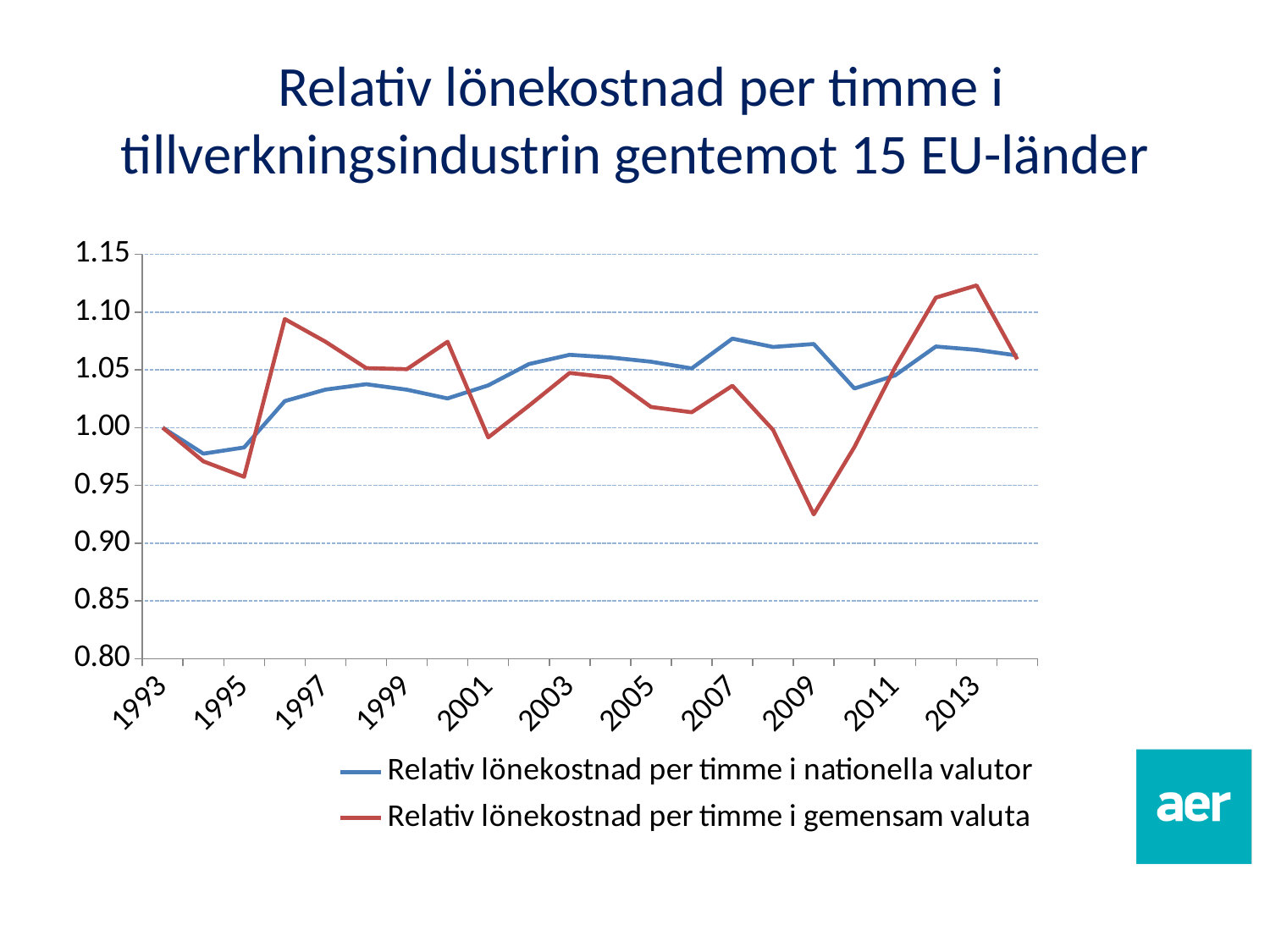
What kind of chart is shown on the slide? line chart Is the value for 'Relativ lönekostnad per timme i gemensam valuta' in 2009 greater or less than 0.95? less What is the value of both series in 1993? 1.00 Which series is drawn in red? Relativ lönekostnad per timme i gemensam valuta Is the value for 'Relativ lönekostnad per timme i gemensam valuta' in 2013 greater or less than 1.10? greater What is the title of the chart? Relativ lönekostnad per timme i tillverkningsindustrin gentemot 15 EU-länder Is the value for 'Relativ lönekostnad per timme i nationella valutor' in 2010 greater or less than 1.05? less How many series does the legend list? 2 In 2009, which series has the higher value? Relativ lönekostnad per timme i nationella valutor In which year is the value for 'Relativ lönekostnad per timme i gemensam valuta' highest? 2013 Does the value for 'Relativ lönekostnad per timme i gemensam valuta' rise or fall from 2009 to 2013? rise In which year is the value for 'Relativ lönekostnad per timme i gemensam valuta' lowest? 2009